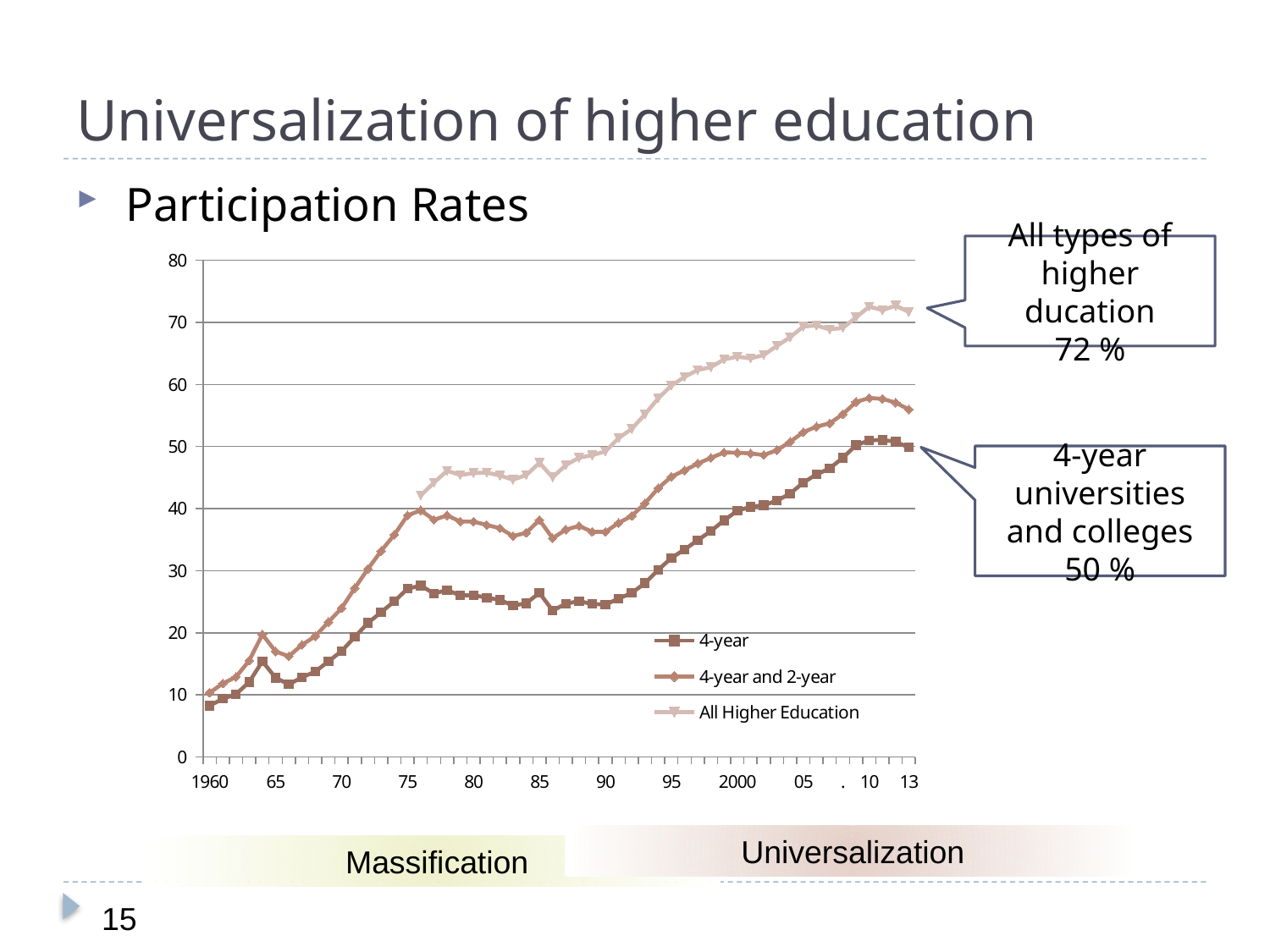
Is the value for the 4-year and 2-year series in 2010 greater or less than 50? greater Which series has the highest values across the chart? All Higher Education Which series has the lowest values across the chart? 4-year What is the difference between the all types of higher education rate (72 %) and the 4-year universities and colleges rate (50 %) shown in the callouts? 22 % According to the callout, what is the participation rate for 4-year universities and colleges in the final year? 50 % According to the callout, what is the participation rate for all types of higher education in the final year? 72 % What is the first year shown on the x axis? 1960 Is the value for the All Higher Education series in 2000 greater or less than 60? greater Do the participation rates generally rise or fall from 1960 to 2013? rise What kind of chart is shown on the slide? line chart Is the value for the 4-year series in 1960 greater or less than 10? less How many series does the legend list? 3